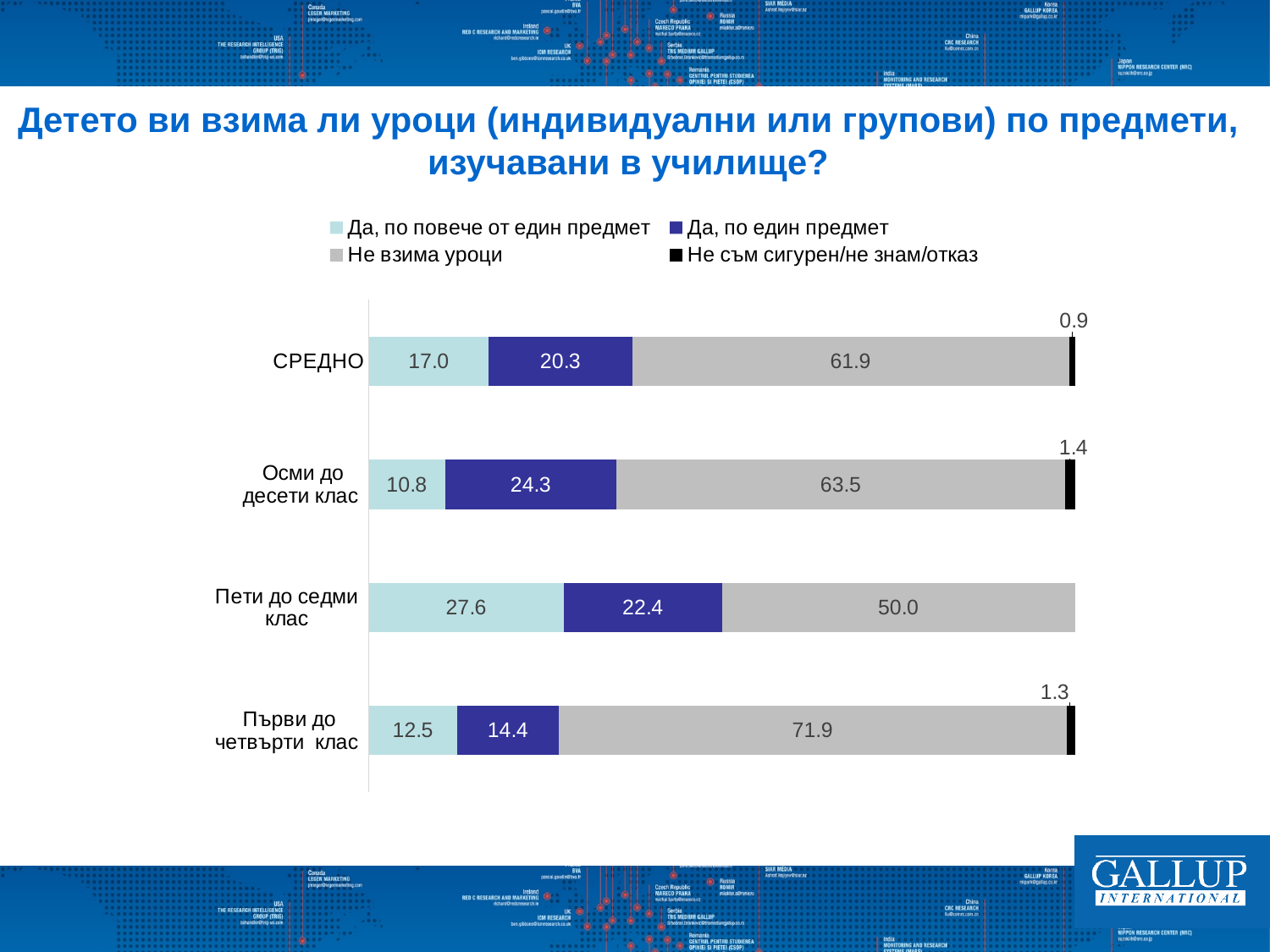
How many series does the legend list? 4 What is the value for "Да, по повече от един предмет" in the "СРЕДНО" category? 17.0 Which category has the highest value for "Да, по повече от един предмет"? Пети до седми клас How many categories are shown on the chart? 4 What kind of chart is shown on the slide? Stacked bar chart What is the total of the printed values in the "Осми до десети клас" bar? 100.0 Which is larger for "Да, по един предмет": "Осми до десети клас" or "Пети до седми клас"? Осми до десети клас What is the value for "Не съм сигурен/не знам/отказ" in the "Осми до десети клас" category? 1.4 What is the difference between the "Не взима уроци" values for "Първи до четвърти клас" and "Пети до седми клас"? 21.9 Which category has the lowest value for "Не взима уроци"? Пети до седми клас What is the value for "Не взима уроци" in the "Първи до четвърти клас" category? 71.9 Which legend entry is shown in black? Не съм сигурен/не знам/отказ